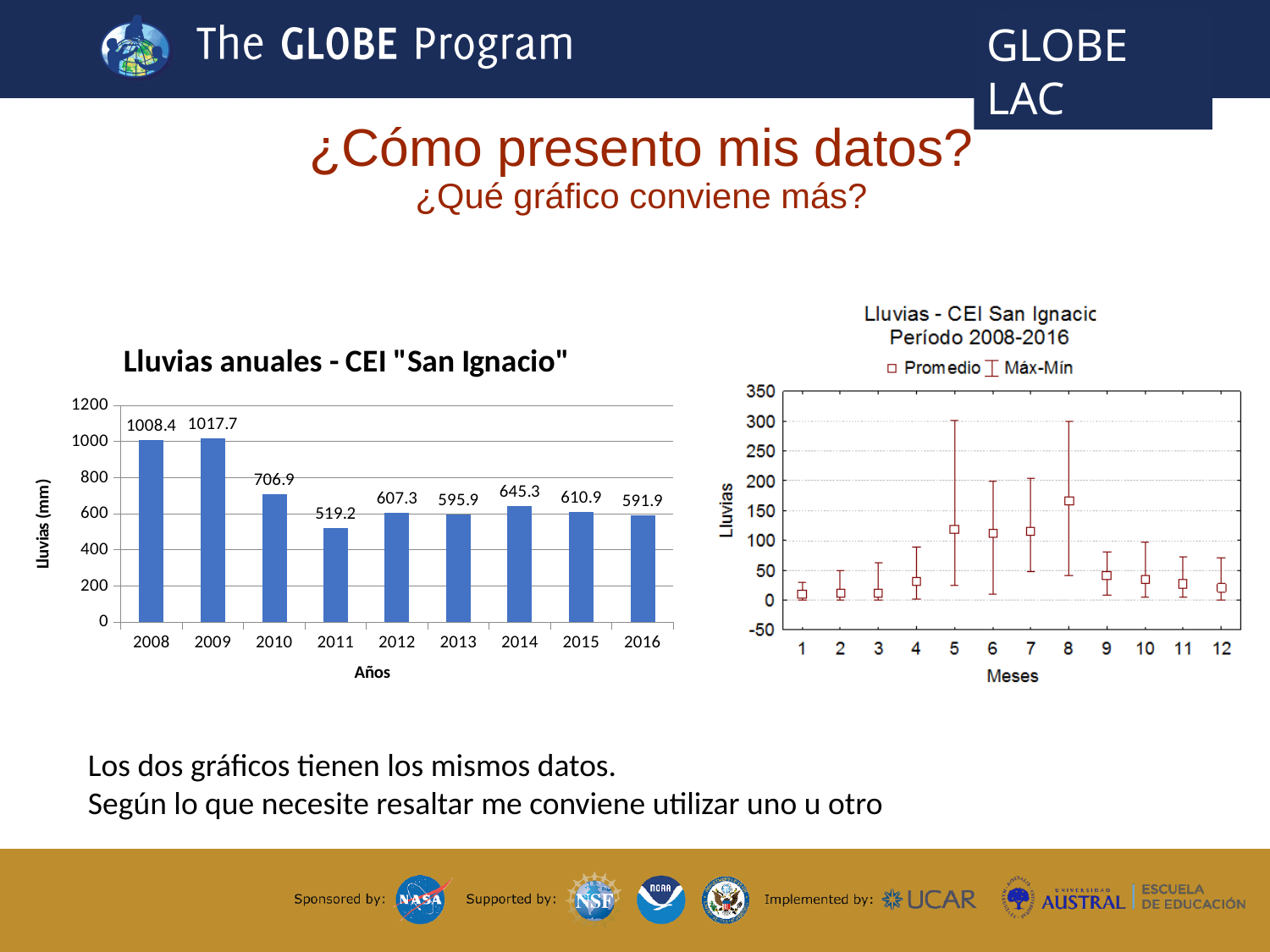
In the bar chart "Lluvias anuales - CEI "San Ignacio"", what is the value for 2014? 645.3 In the right chart "Lluvias - CEI San Ignacio Período 2008-2016", is the average (Promedio) value for month 1 greater or less than 50? less What kind of chart is the left chart, "Lluvias anuales - CEI "San Ignacio""? bar chart In the bar chart "Lluvias anuales - CEI "San Ignacio"", what is the label of the y axis? Lluvias (mm) In the bar chart "Lluvias anuales - CEI "San Ignacio"", which year has the lowest value? 2011 In the bar chart "Lluvias anuales - CEI "San Ignacio"", what is the difference between the values for 2009 and 2010? 310.8 In the right chart "Lluvias - CEI San Ignacio Período 2008-2016", how many months are shown on the x axis? 12 In the bar chart "Lluvias anuales - CEI "San Ignacio"", which is larger, the value for 2012 or the value for 2013? 2012 In the bar chart "Lluvias anuales - CEI "San Ignacio"", which year has the highest value? 2009 In the right chart "Lluvias - CEI San Ignacio Período 2008-2016", is the average (Promedio) value for month 8 greater or less than 150? greater In the bar chart "Lluvias anuales - CEI "San Ignacio"", how many years are shown on the x axis? 9 In the bar chart "Lluvias anuales - CEI "San Ignacio"", what is the value for 2011? 519.2